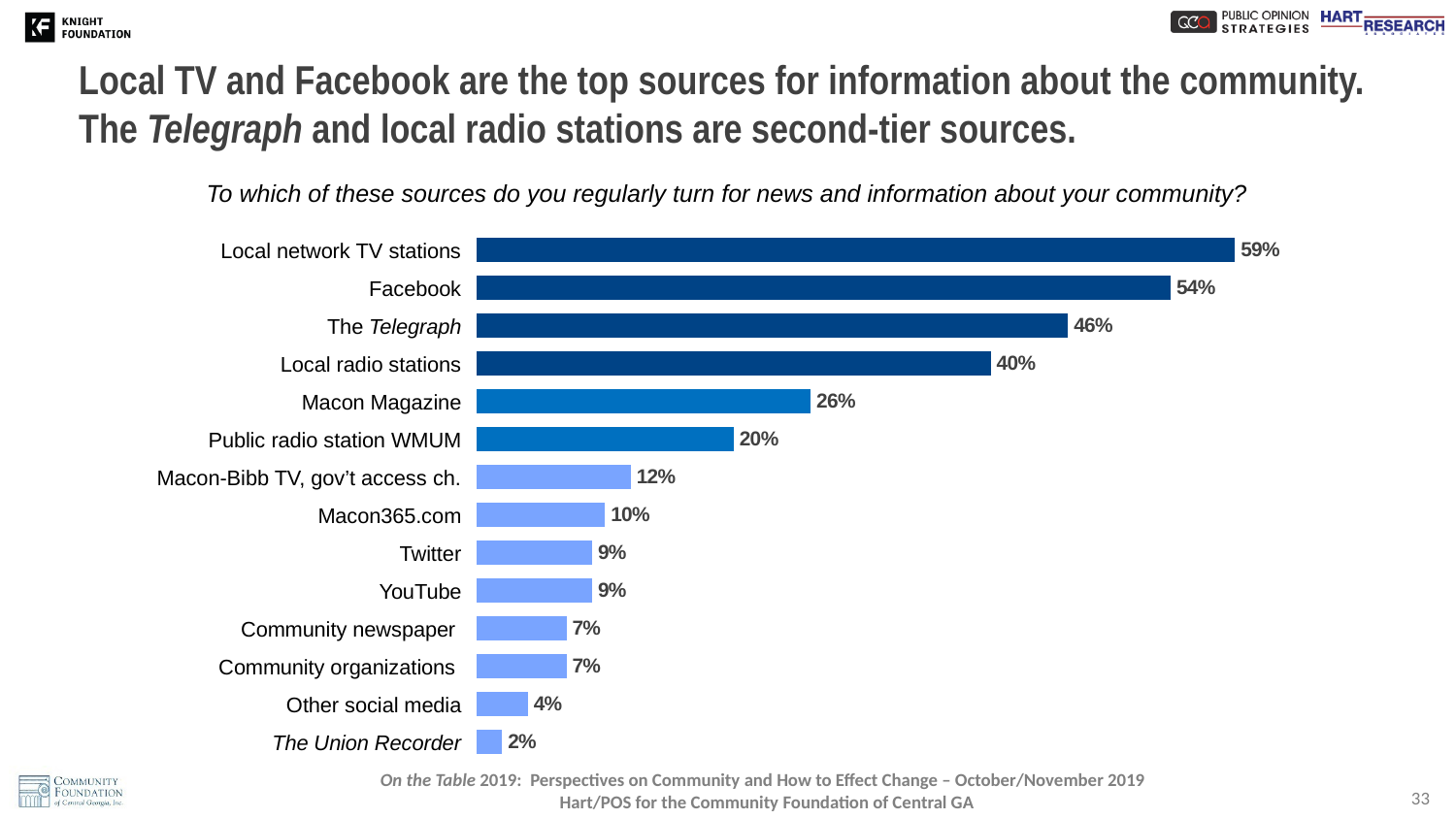
Which source has the lowest percentage in the chart? The Union Recorder What percentage is shown for Public radio station WMUM? 20% How many sources are listed in the chart? 14 What is the value shown for Facebook? 54% What is the difference in percentage points between The Telegraph and Local radio stations? 6 What is the value for Macon365.com? 10% Which two sources both have a value of 9%? Twitter and YouTube What type of chart is shown on the slide? Bar chart What percentage of respondents regularly turn to Local network TV stations for news about their community? 59% Which source has the highest percentage in the chart? Local network TV stations What is the difference in percentage points between Local network TV stations and Facebook? 5 Which has a higher value, Macon Magazine or Public radio station WMUM? Macon Magazine